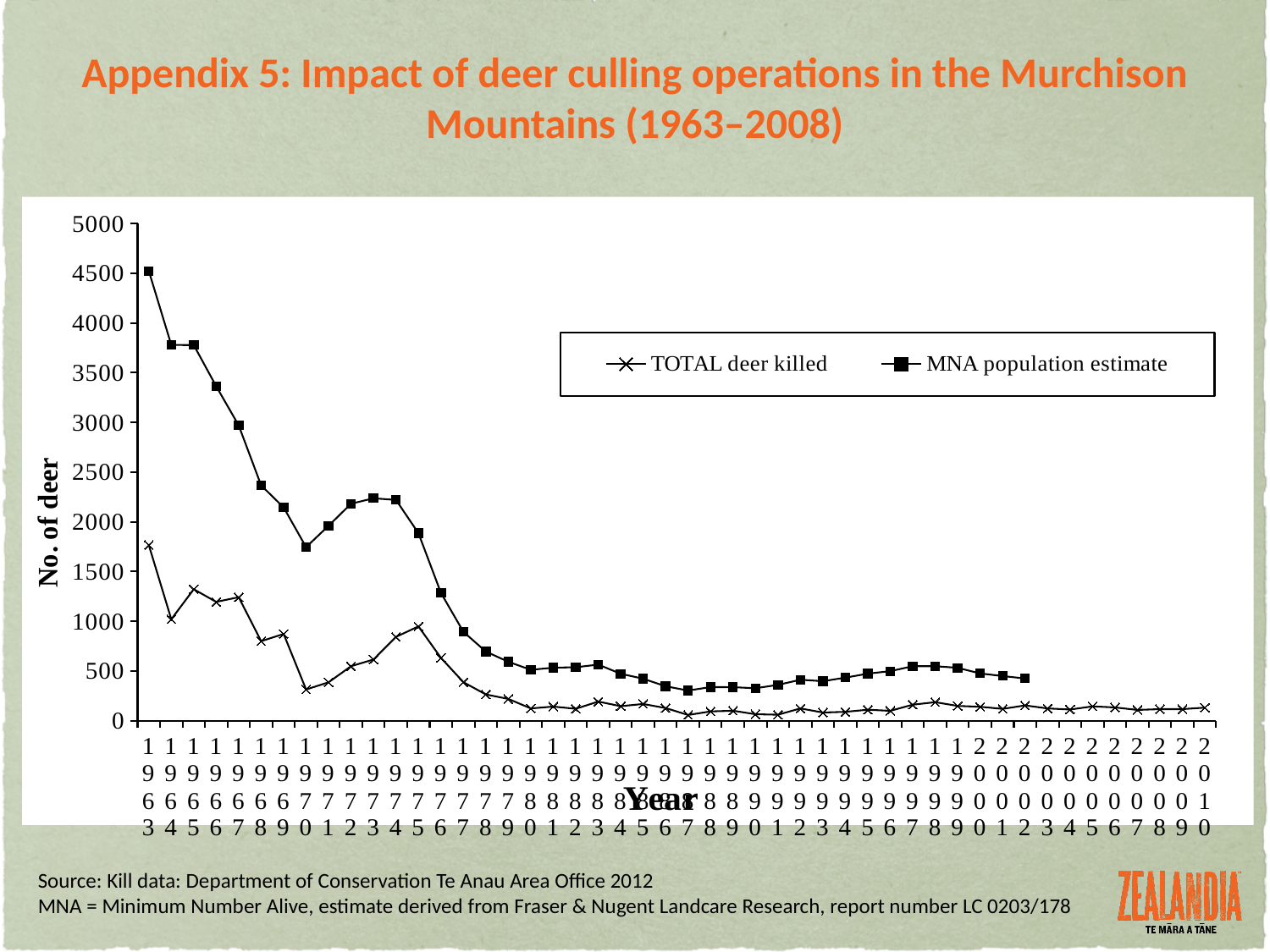
Is the MNA population estimate for 1966 greater or less than 3000? greater How many series does the legend list? 2 What kind of chart is shown on the slide? Line chart In which year is the MNA population estimate highest? 1963 Is the TOTAL deer killed value for 1963 greater or less than 1500? greater Is the MNA population estimate for 1970 greater or less than 2000? less How many years are shown along the x axis? 48 Does the MNA population estimate generally rise or fall from 1963 to 2002? fall In 1963, which is larger: the MNA population estimate or the TOTAL deer killed? MNA population estimate What is the title of the y axis? No. of deer